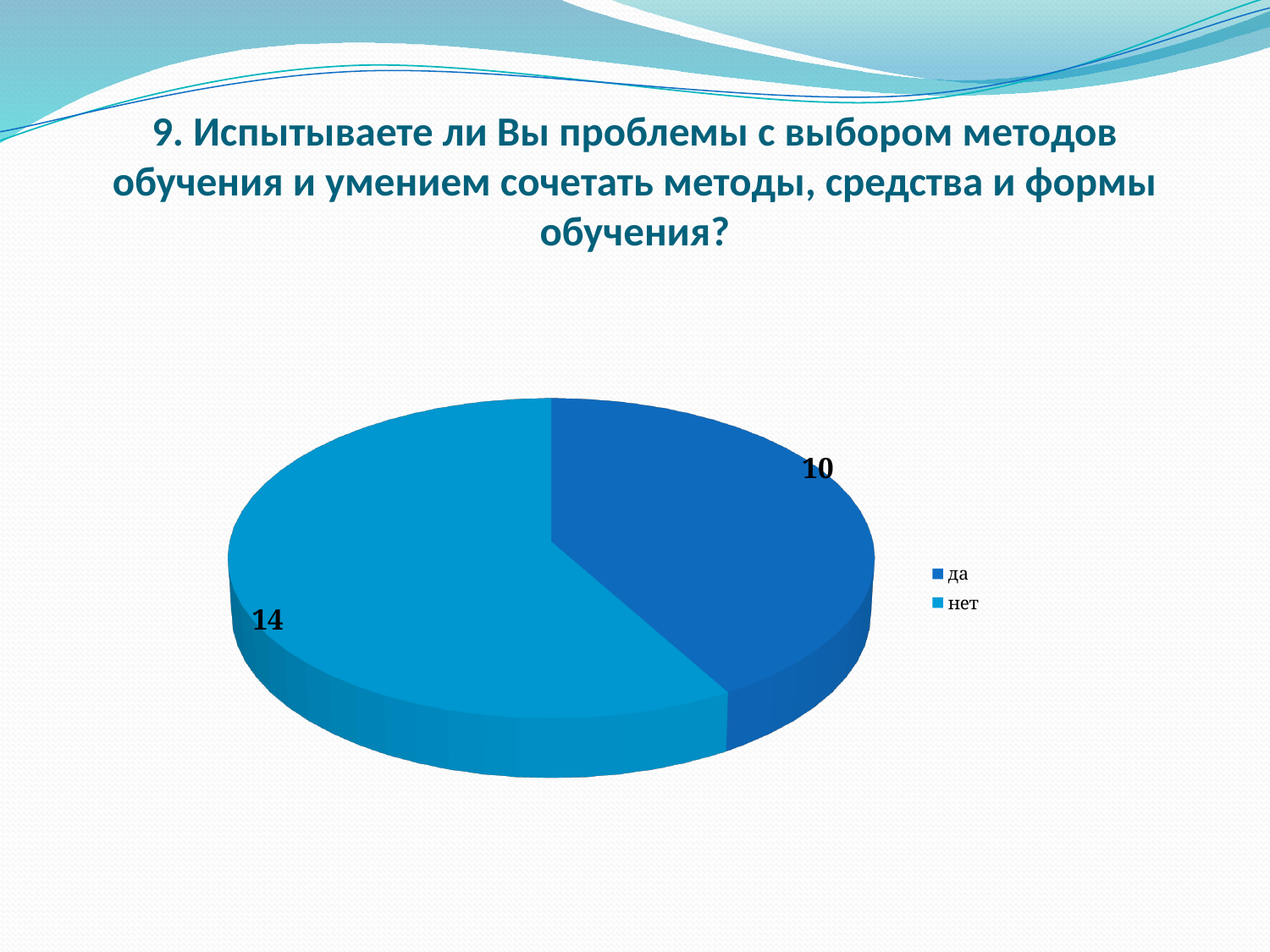
What is the value for "нет"? 14 Which is larger, the value for "да" or the value for "нет"? нет How many slices does the pie chart have? 2 How many entries does the legend list? 2 What is the difference between the values for "нет" and "да"? 4 What is the value for "да"? 10 Where is the legend positioned relative to the pie? to the right Which legend entry is shown in the darker blue colour? да What kind of chart is shown on the slide? pie chart What is the total of all slices in the pie chart? 24 Which category has the smallest slice? да Which category has the largest slice? нет